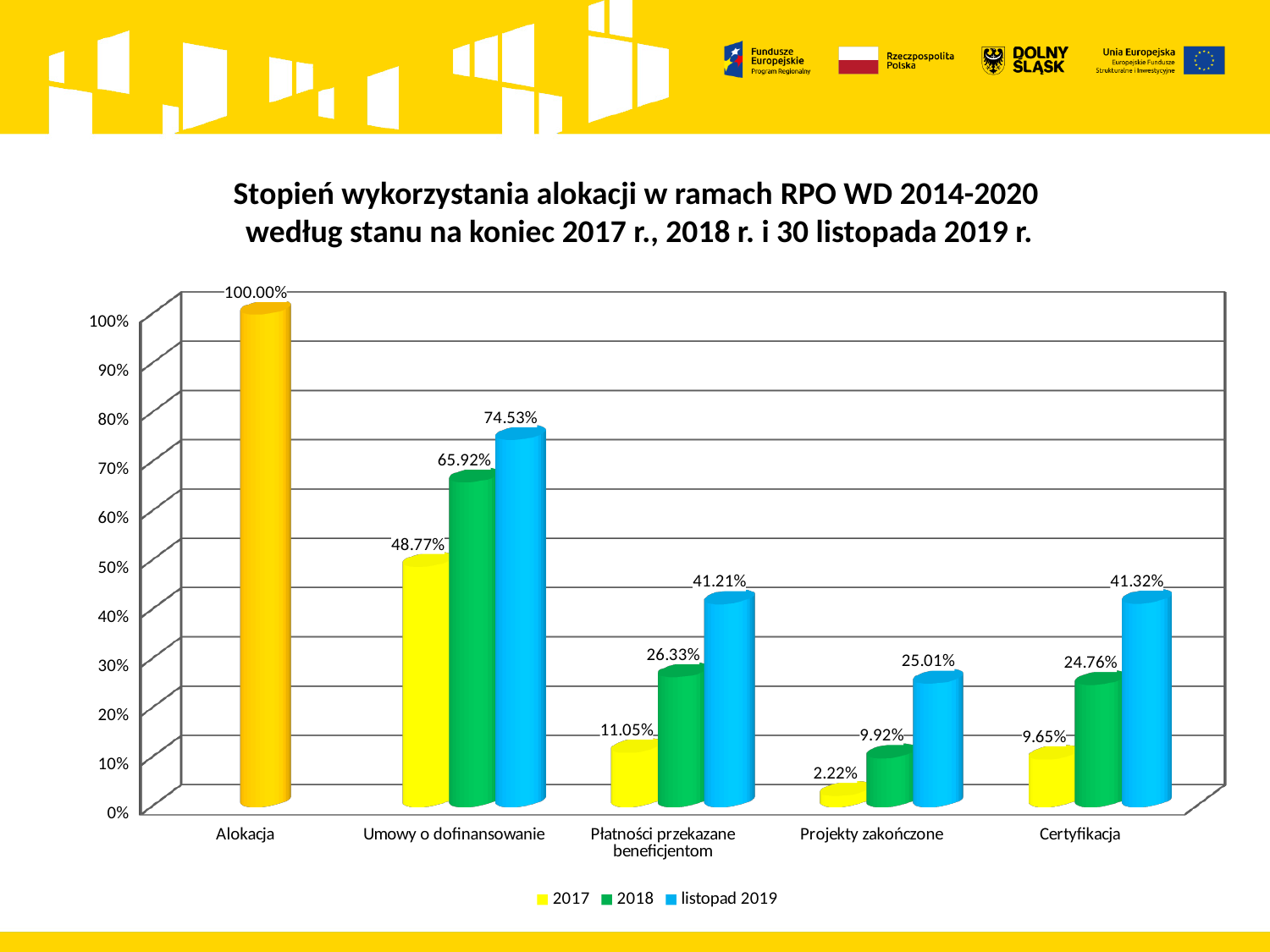
What is the value for 'listopad 2019' in the 'Umowy o dofinansowanie' category? 74.53% How many series does the legend list? 3 How many categories are shown on the x axis? 5 Which colour represents the 2018 series in the legend? Green Which category has the lowest 2017 value? Projekty zakończone What kind of chart is shown on the slide? Bar chart What is the value for 2018 in the 'Certyfikacja' category? 24.76% What is the value shown for 'Alokacja'? 100.00% Which category has the highest 'listopad 2019' value? Umowy o dofinansowanie Which is larger: the 'listopad 2019' value for 'Certyfikacja' or for 'Płatności przekazane beneficjentom'? Certyfikacja What is the difference between the 2018 and 2017 values for 'Projekty zakończone'? 7.70% What is the value for 2017 in the 'Płatności przekazane beneficjentom' category? 11.05%